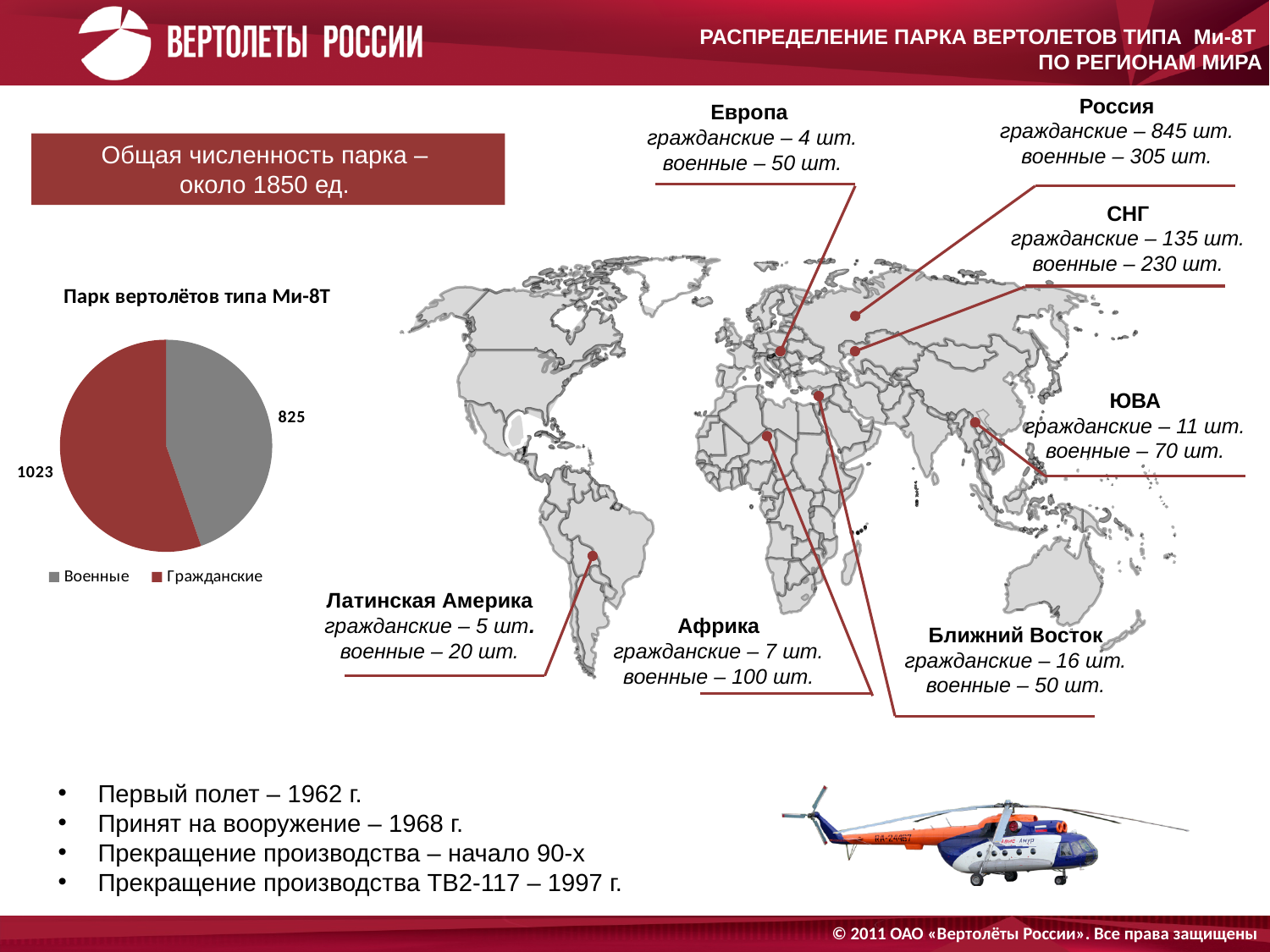
In the pie chart "Парк вертолётов типа Ми-8Т", what colour is the Гражданские slice? Red How many entries does the legend of the pie chart "Парк вертолётов типа Ми-8Т" list? 2 In the pie chart "Парк вертолётов типа Ми-8Т", which category has the largest slice? Гражданские In the pie chart "Парк вертолётов типа Ми-8Т", which category has the smallest slice? Военные What is the title of the pie chart on the left of the slide? Парк вертолётов типа Ми-8Т How many slices does the pie chart "Парк вертолётов типа Ми-8Т" have? 2 In the pie chart "Парк вертолётов типа Ми-8Т", what is the value for Военные? 825 What kind of chart is shown on the left of the slide under the heading "Парк вертолётов типа Ми-8Т"? Pie chart What is the sum of the two values shown in the pie chart "Парк вертолётов типа Ми-8Т"? 1848 In the pie chart "Парк вертолётов типа Ми-8Т", what is the value for Гражданские? 1023 In the pie chart "Парк вертолётов типа Ми-8Т", what is the difference between the Гражданские and Военные values? 198 In the pie chart "Парк вертолётов типа Ми-8Т", which is larger: Военные or Гражданские? Гражданские